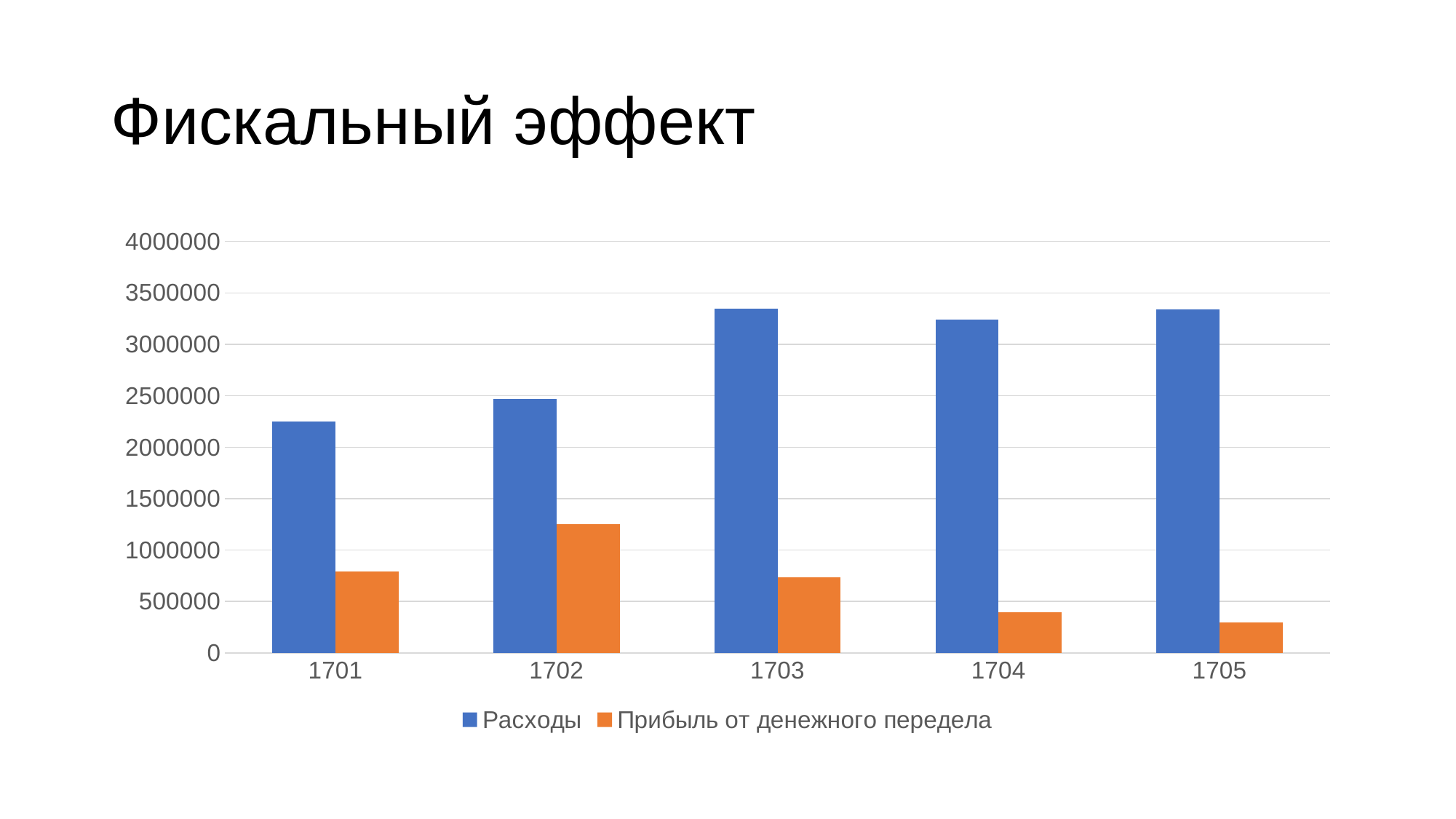
How many categories are shown on the x axis? 5 What kind of chart is shown on the slide? bar chart Which category has the lowest value for Прибыль от денежного передела? 1705 Which category has the highest value for Прибыль от денежного передела? 1702 What is the title of the slide? Фискальный эффект Which category has the lowest value for Расходы? 1701 Is the value for Расходы in 1701 greater or less than 2000000? greater How many series does the legend list? 2 Is the value for Расходы in 1703 greater or less than 3000000? greater Is the value for Прибыль от денежного передела in 1702 greater or less than 1000000? greater Which is larger: Расходы in 1703 or Расходы in 1701? Расходы in 1703